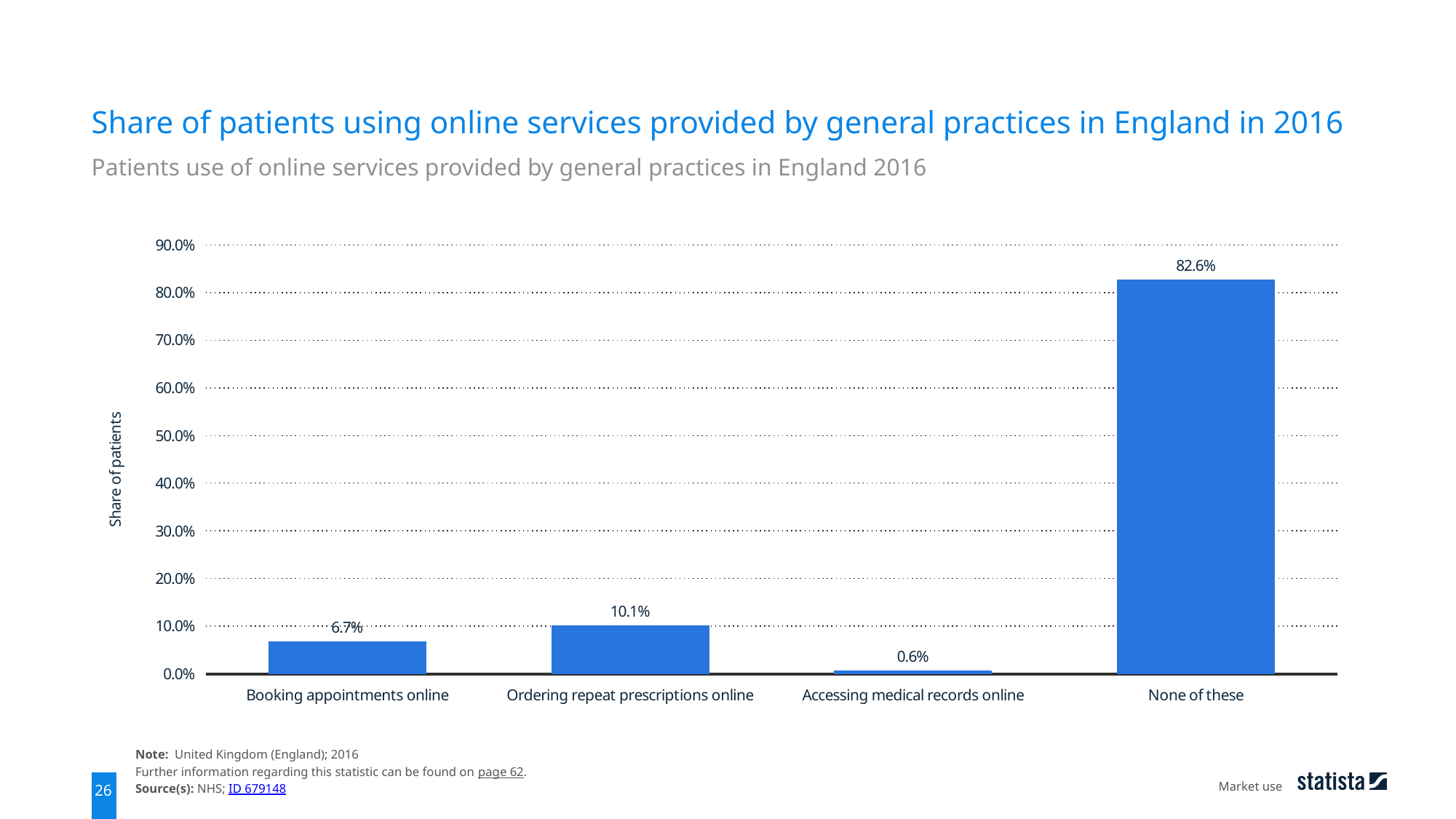
What is the share of patients for Accessing medical records online? 0.6% Which category has the highest share of patients? None of these What is the share of patients for None of these? 82.6% What kind of chart is shown on the slide? Bar chart Which is larger: the share for Booking appointments online or Accessing medical records online? Booking appointments online How many categories are shown on the chart? 4 Which category has the lowest share of patients? Accessing medical records online What is the share of patients for Ordering repeat prescriptions online? 10.1% Is the value for None of these greater or less than 80.0%? greater What is the share of patients for Booking appointments online? 6.7% What is the difference between the share for Ordering repeat prescriptions online and Booking appointments online? 3.4% What is the label of the vertical axis? Share of patients